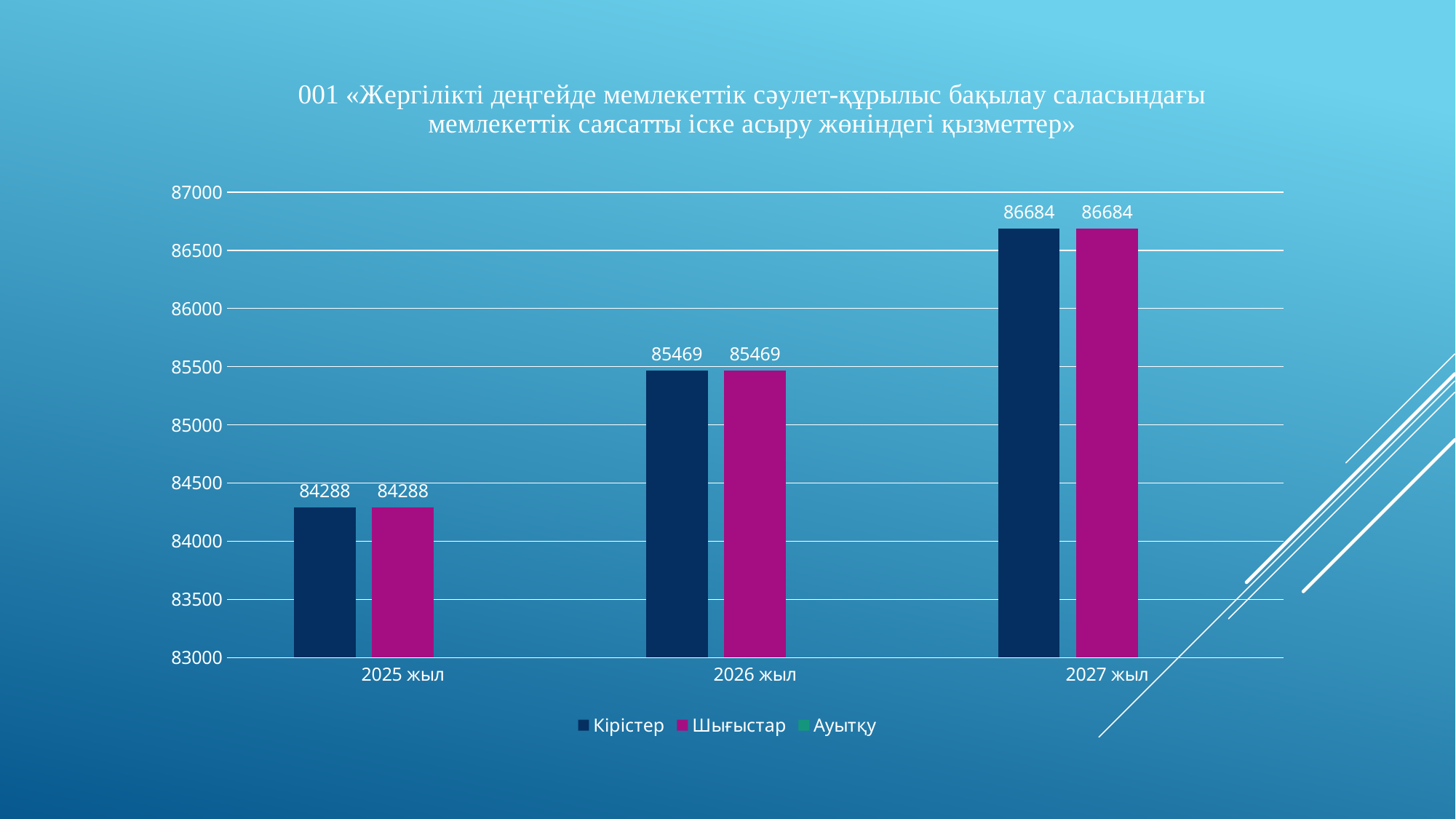
What is the value of Кірістер for 2027 жыл? 86684 What kind of chart is shown on the slide? Bar chart How many years are shown on the x axis? 3 What is the difference between the Шығыстар values for 2026 жыл and 2025 жыл? 1181 Which is larger, the Кірістер value for 2026 жыл or for 2025 жыл? 2026 жыл Which year has the highest Кірістер value? 2027 жыл What is the value of Кірістер for 2025 жыл? 84288 Which year has the lowest Шығыстар value? 2025 жыл Is the Кірістер value for 2026 жыл greater or less than 85000? greater What is the value of Шығыстар for 2026 жыл? 85469 How many series does the legend list? 3 What is the difference between the Кірістер values for 2027 жыл and 2025 жыл? 2396